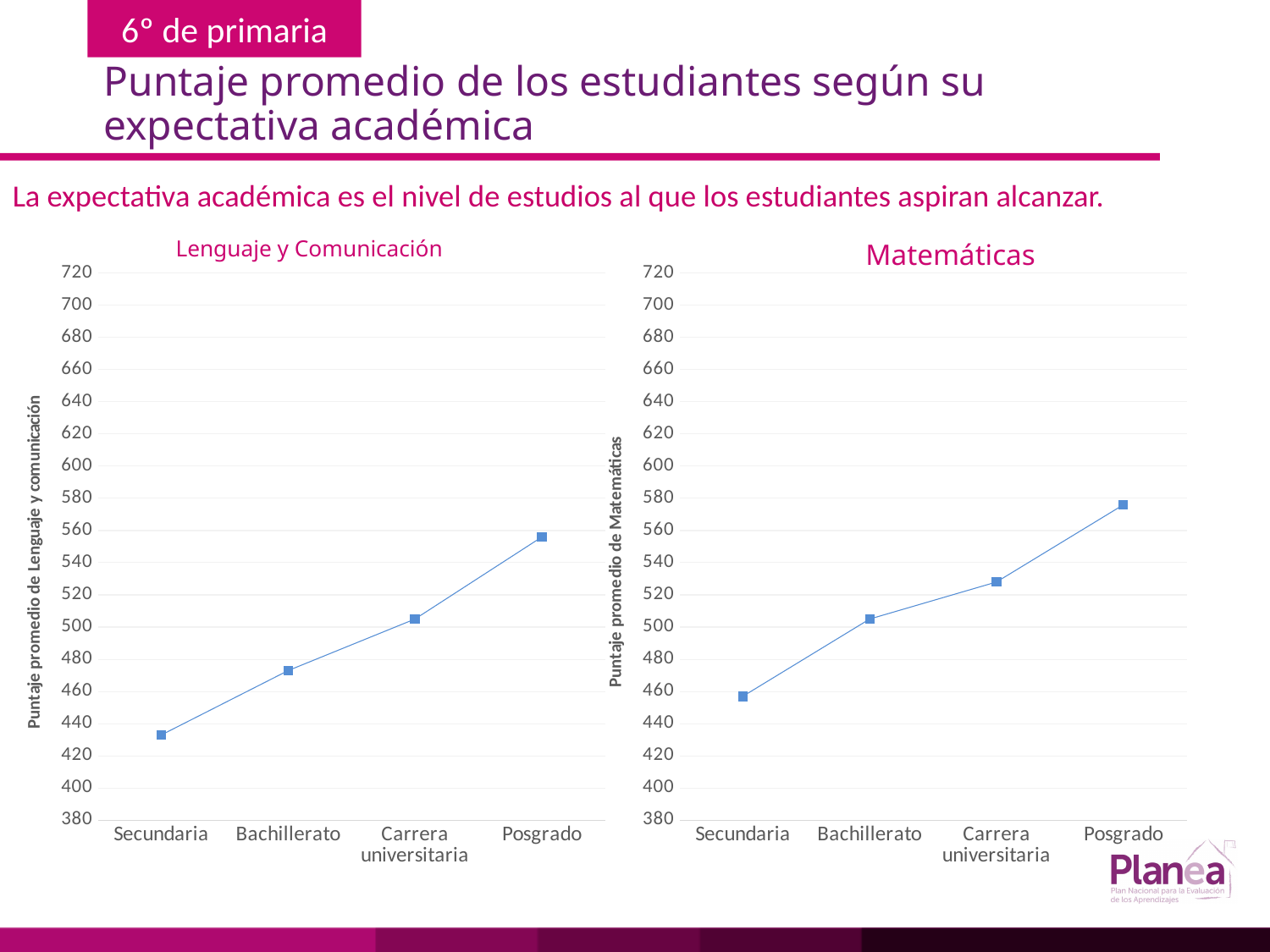
In the Lenguaje y Comunicación chart, do the values rise or fall from Secundaria to Posgrado? rise In the Matemáticas chart, which category has the highest average score? Posgrado In the Matemáticas chart, is the value for Bachillerato greater or less than 500? greater In the Matemáticas chart, is the value for Posgrado greater or less than 560? greater In the Lenguaje y Comunicación chart, which category has the lowest average score? Secundaria What kind of chart is the Lenguaje y Comunicación chart? line chart In the Matemáticas chart, which category has the lowest average score? Secundaria How many categories are shown on the x axis of the Matemáticas chart? 4 In the Lenguaje y Comunicación chart, is the value for Secundaria greater or less than 440? less In the Lenguaje y Comunicación chart, which category has the highest average score? Posgrado In the Matemáticas chart, which is larger, the value for Secundaria or the value for Carrera universitaria? Carrera universitaria